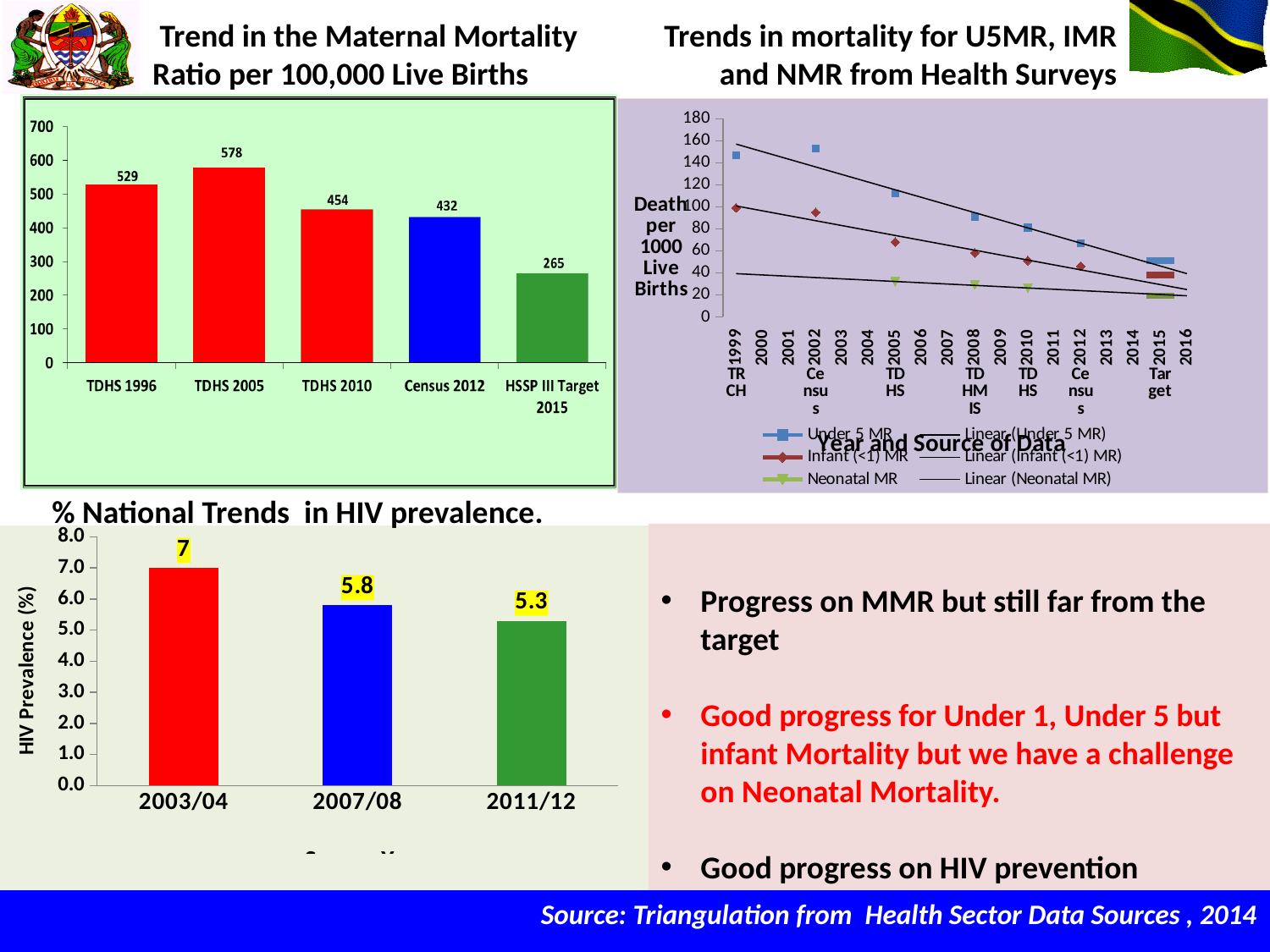
In the '% National Trends in HIV prevalence' chart, what is the HIV prevalence for 2007/08? 5.8 In the 'Trend in the Maternal Mortality Ratio per 100,000 Live Births' chart, which category has the highest value? TDHS 2005 What kind of chart is the '% National Trends in HIV prevalence' chart? bar chart In the 'Trend in the Maternal Mortality Ratio per 100,000 Live Births' chart, how many categories are shown? 5 In the 'Trend in the Maternal Mortality Ratio per 100,000 Live Births' chart, which category has the lowest value? HSSP III Target 2015 In the '% National Trends in HIV prevalence' chart, do the values rise or fall from 2003/04 to 2011/12? fall In the 'Trend in the Maternal Mortality Ratio per 100,000 Live Births' chart, what is the value for Census 2012? 432 In the 'Trends in mortality for U5MR, IMR and NMR from Health Surveys' chart, is the Neonatal MR value for 2005 TDHS greater or less than 40? less In the 'Trends in mortality for U5MR, IMR and NMR from Health Surveys' chart, how many data series does the legend list? 6 In the 'Trend in the Maternal Mortality Ratio per 100,000 Live Births' chart, what is the difference between the TDHS 1996 value and the TDHS 2010 value? 75 In the 'Trend in the Maternal Mortality Ratio per 100,000 Live Births' chart, what is the value for TDHS 2005? 578 In the 'Trends in mortality for U5MR, IMR and NMR from Health Surveys' chart, is the Under 5 MR value for 1999 TRCH greater or less than 140? greater